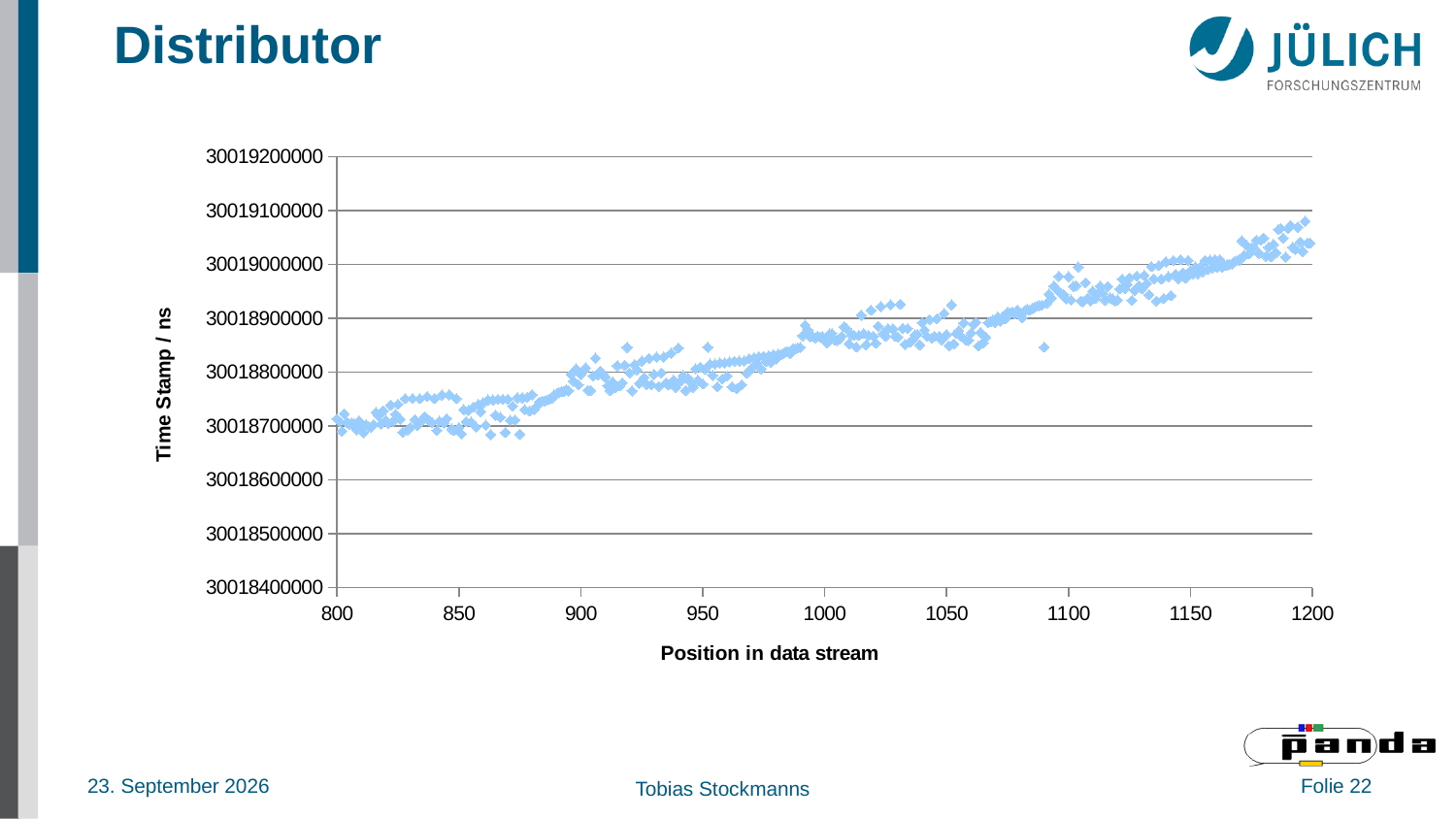
What is the label of the y axis of the chart? Time Stamp / ns Which has the smaller time stamp value, position 850 or position 1150? position 850 Is the time stamp value at position 1000 greater or less than 30018800000? greater Is the time stamp value at position 1200 greater or less than 30019000000? greater Is the time stamp value at position 1000 greater or less than 30019000000? less What is the label of the x axis of the chart? Position in data stream What is the lowest value shown on the y axis of the chart? 30018400000 Do the time stamp values rise or fall as the position in the data stream increases from 800 to 1200? rise Which has the larger time stamp value, position 800 or position 1200? position 1200 What kind of chart is shown on the slide? scatter chart